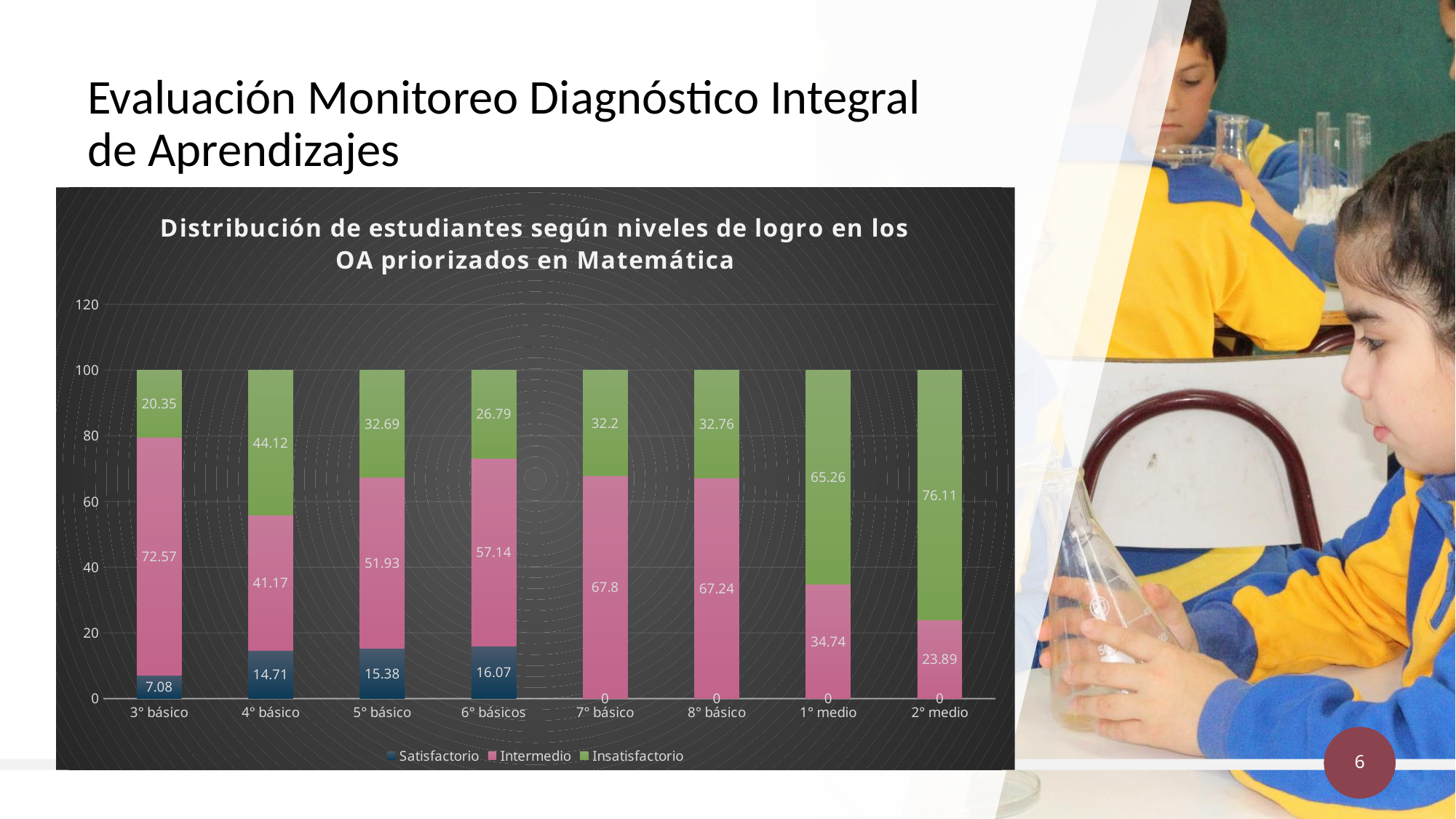
Which category has the highest Insatisfactorio value? 2° medio What kind of chart is shown on the slide? Stacked bar chart What is the total of the stacked bar for 4° básico? 100 How many series does the legend list? 3 What is the Intermedio value for 3° básico? 72.57 Which category has the lowest Intermedio value? 2° medio Is the Intermedio value for 7° básico greater or less than 60? greater What is the Insatisfactorio value for 2° medio? 76.11 What is the difference between the Insatisfactorio values for 1° medio and 3° básico? 44.91 What is the Satisfactorio value for 6° básicos? 16.07 How many categories are shown on the x axis? 8 Which is larger, the Intermedio value for 5° básico or for 6° básicos? 6° básicos